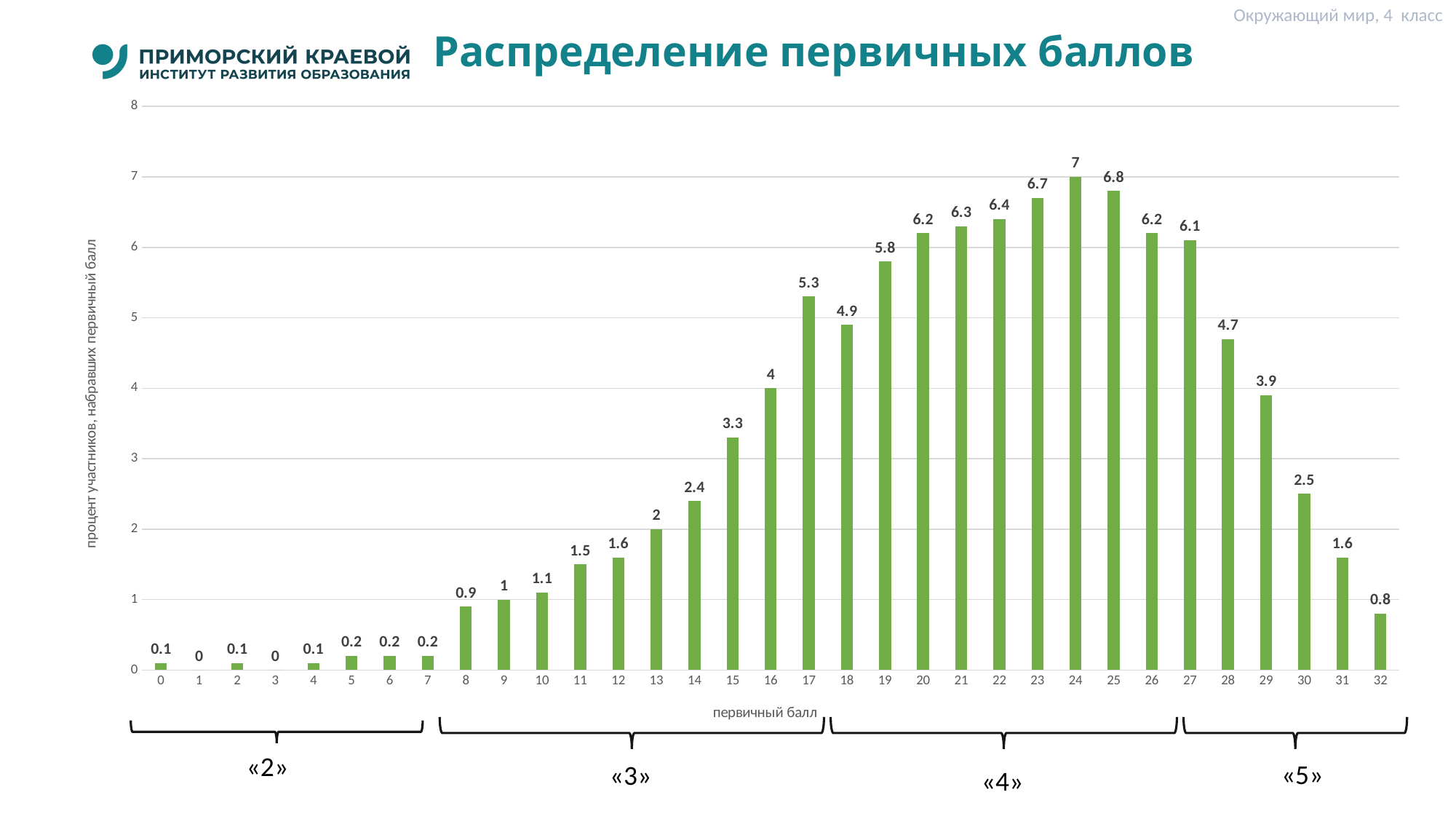
What type of chart is shown on the slide? bar chart Which is larger: the value for primary score 19 or for primary score 28? 19 What is the value shown for a primary score of 17? 5.3 Is the value for primary score 29 greater or less than 3? greater What percentage of participants scored 24 primary points? 7 How many primary score categories are shown on the x axis? 33 Which primary score has the highest percentage of participants? 24 What is the value shown for a primary score of 32? 0.8 What is the difference between the values for primary scores 17 and 18? 0.4 What is the difference between the values for primary scores 24 and 25? 0.2 What is the lowest value shown on the chart? 0 Do the values rise or fall as the primary score increases from 8 to 17? rise